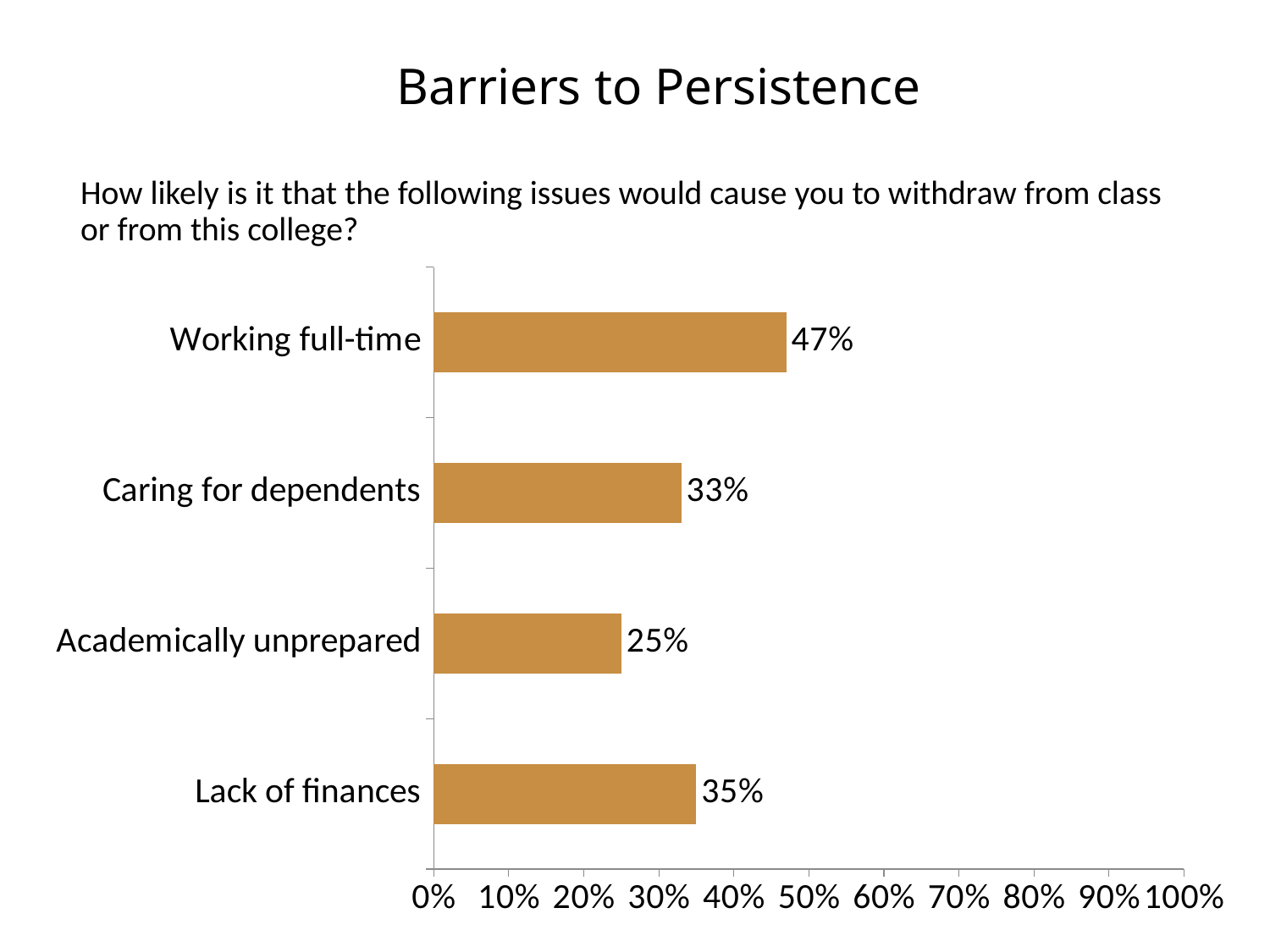
What is the value for Working full-time? 47% What is the difference between the values for Working full-time and Lack of finances? 12% What is the difference between the values for Caring for dependents and Academically unprepared? 8% What is the value for Caring for dependents? 33% What is the value for Academically unprepared? 25% What is the value for Lack of finances? 35% What kind of chart is shown on the slide? Bar chart Is the value for Working full-time greater or less than 50%? less Which is larger, the value for Lack of finances or the value for Caring for dependents? Lack of finances How many categories are shown in the chart? 4 Which category has the highest value? Working full-time Which category has the lowest value? Academically unprepared